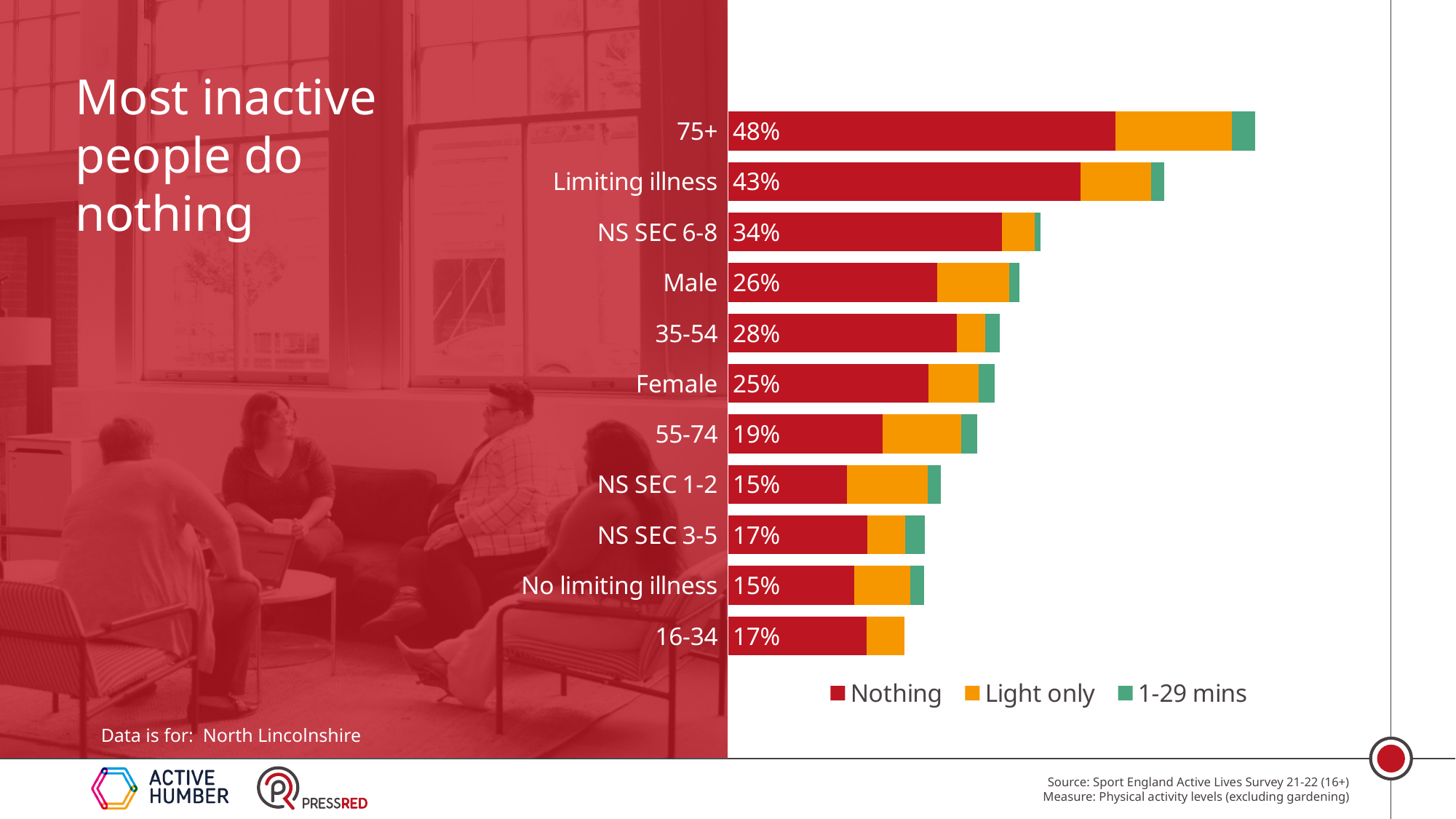
What are the three series named in the legend? Nothing, Light only, 1-29 mins What is the 'Nothing' value for the 55-74 age group? 19% What percentage of males do nothing? 26% Which category has the highest 'Nothing' percentage? 75+ Which has a higher 'Nothing' percentage, Male or Female? Male What is the difference in 'Nothing' percentage between the 75+ group and the Limiting illness group? 5 percentage points What type of chart is shown on the slide? Stacked bar chart What is the 'Nothing' value for people with a limiting illness? 43% What percentage of people aged 75+ do nothing? 48% How many categories are shown in the chart? 11 How many series does the legend list? 3 Which has a higher 'Nothing' percentage, NS SEC 6-8 or NS SEC 1-2? NS SEC 6-8